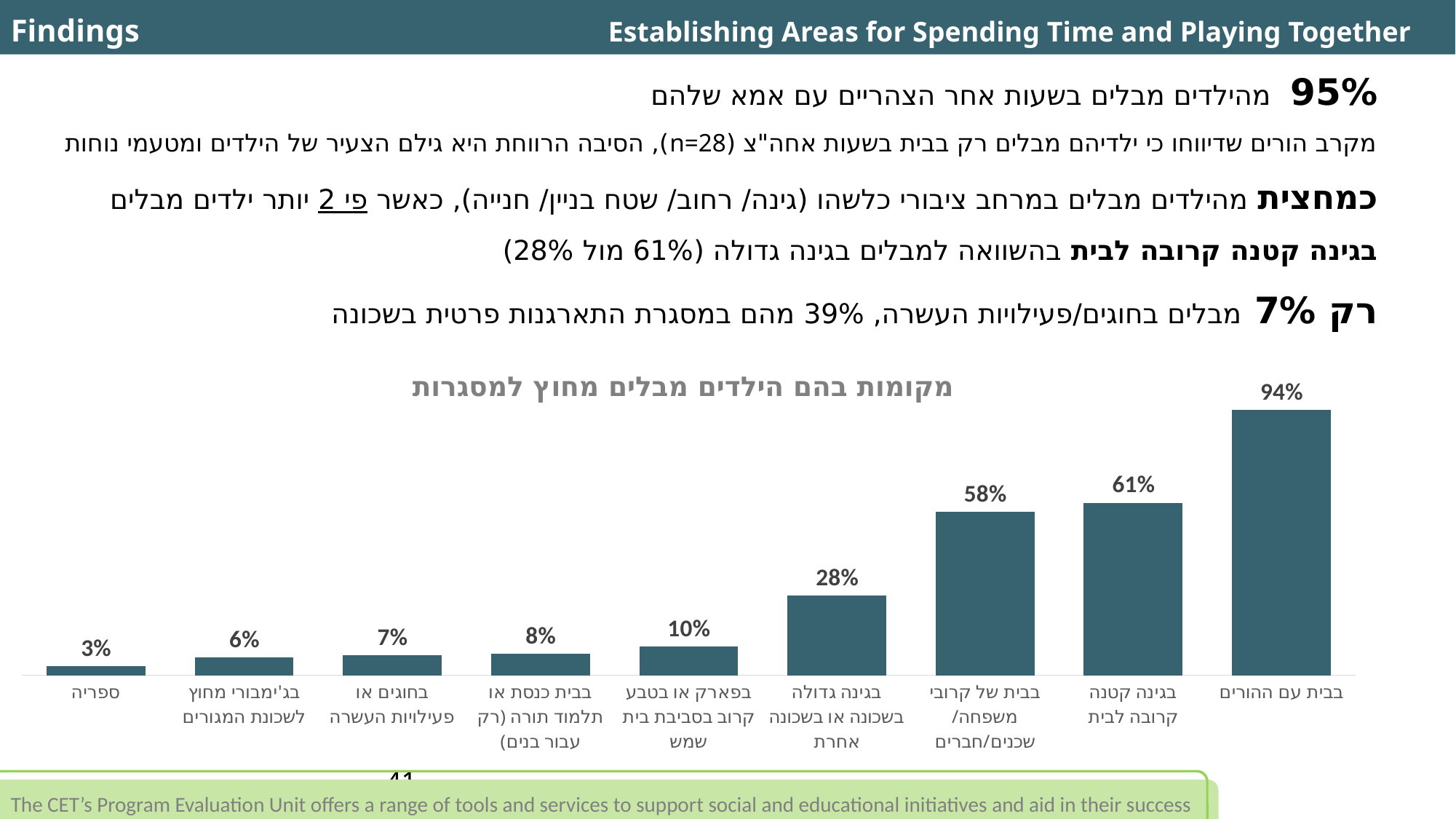
What is the value for בגינה קטנה קרובה לבית? 61% How many categories are shown in the chart? 9 What is the value for בפארק או בטבע קרוב בסביבת בית שמש? 10% Which category has the highest value? בבית עם ההורים What kind of chart is shown on the slide? Bar chart What is the title of the chart? מקומות בהם הילדים מבלים מחוץ למסגרות What is the value for ספריה? 3% Do the values rise or fall moving from left to right along the x axis? Rise What is the difference between the values for בגינה קטנה קרובה לבית and בגינה גדולה בשכונה או בשכונה אחרת? 33% What is the value for בבית עם ההורים? 94% Which is larger, the value for בבית של קרובי משפחה/ שכנים/חברים or the value for בגינה גדולה בשכונה או בשכונה אחרת? בבית של קרובי משפחה/ שכנים/חברים Which category has the lowest value? ספריה